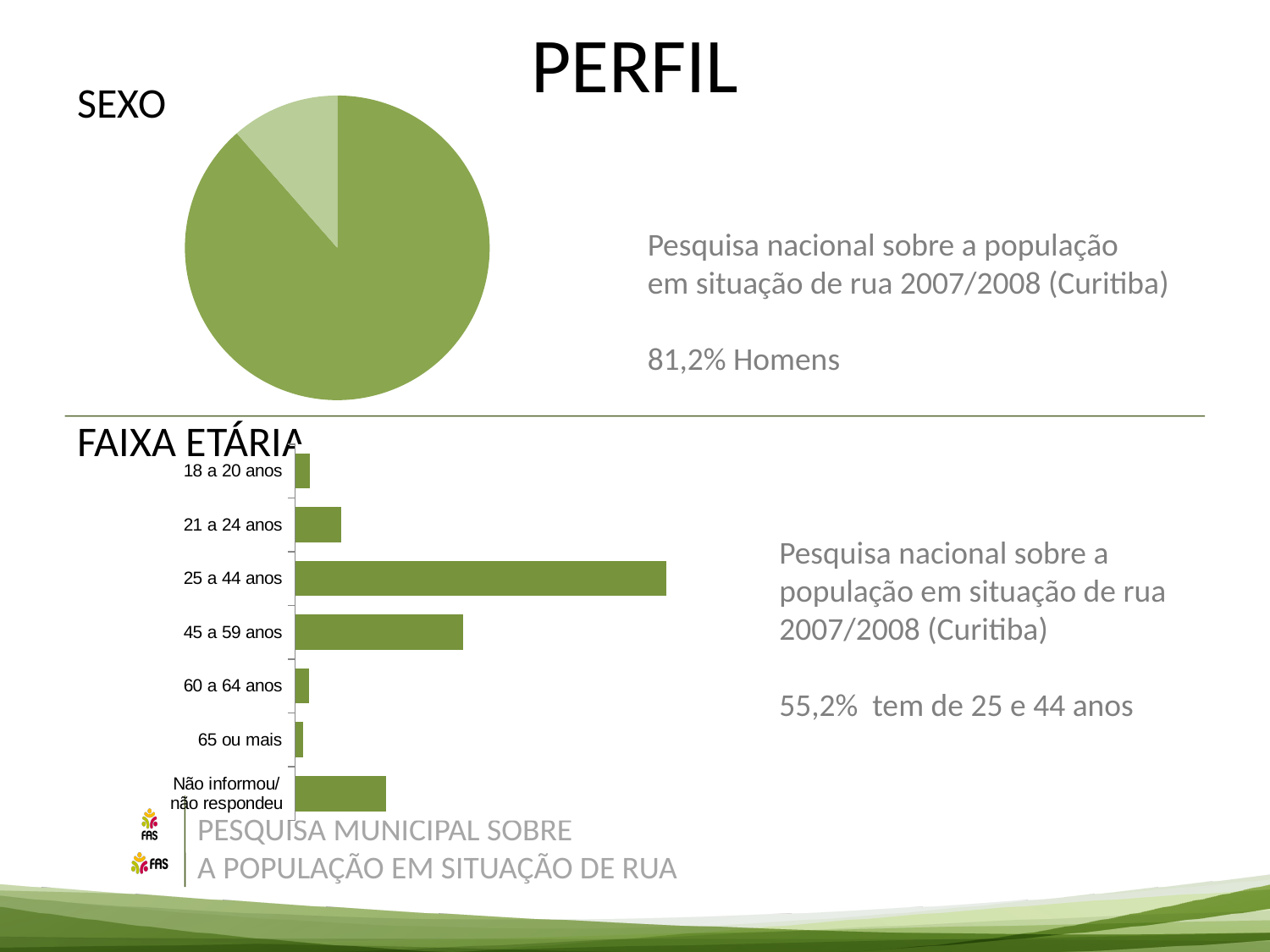
In the FAIXA ETÁRIA bar chart, which age category has the longest bar? 25 a 44 anos In the FAIXA ETÁRIA bar chart, which bar is longer: 21 a 24 anos or 65 ou mais? 21 a 24 anos What kind of chart is the FAIXA ETÁRIA chart at the bottom of the slide? bar chart How many slices does the SEXO pie chart have? 2 In the FAIXA ETÁRIA bar chart, which bar is longer: 45 a 59 anos or 21 a 24 anos? 45 a 59 anos What is the label of the first (top) category in the FAIXA ETÁRIA bar chart? 18 a 20 anos How many age categories are shown in the FAIXA ETÁRIA bar chart? 7 In the FAIXA ETÁRIA bar chart, which bar is longer: Não informou/não respondeu or 18 a 20 anos? Não informou/não respondeu What kind of chart is the SEXO chart at the top of the slide? pie chart What is the title shown next to the pie chart at the top of the slide? SEXO